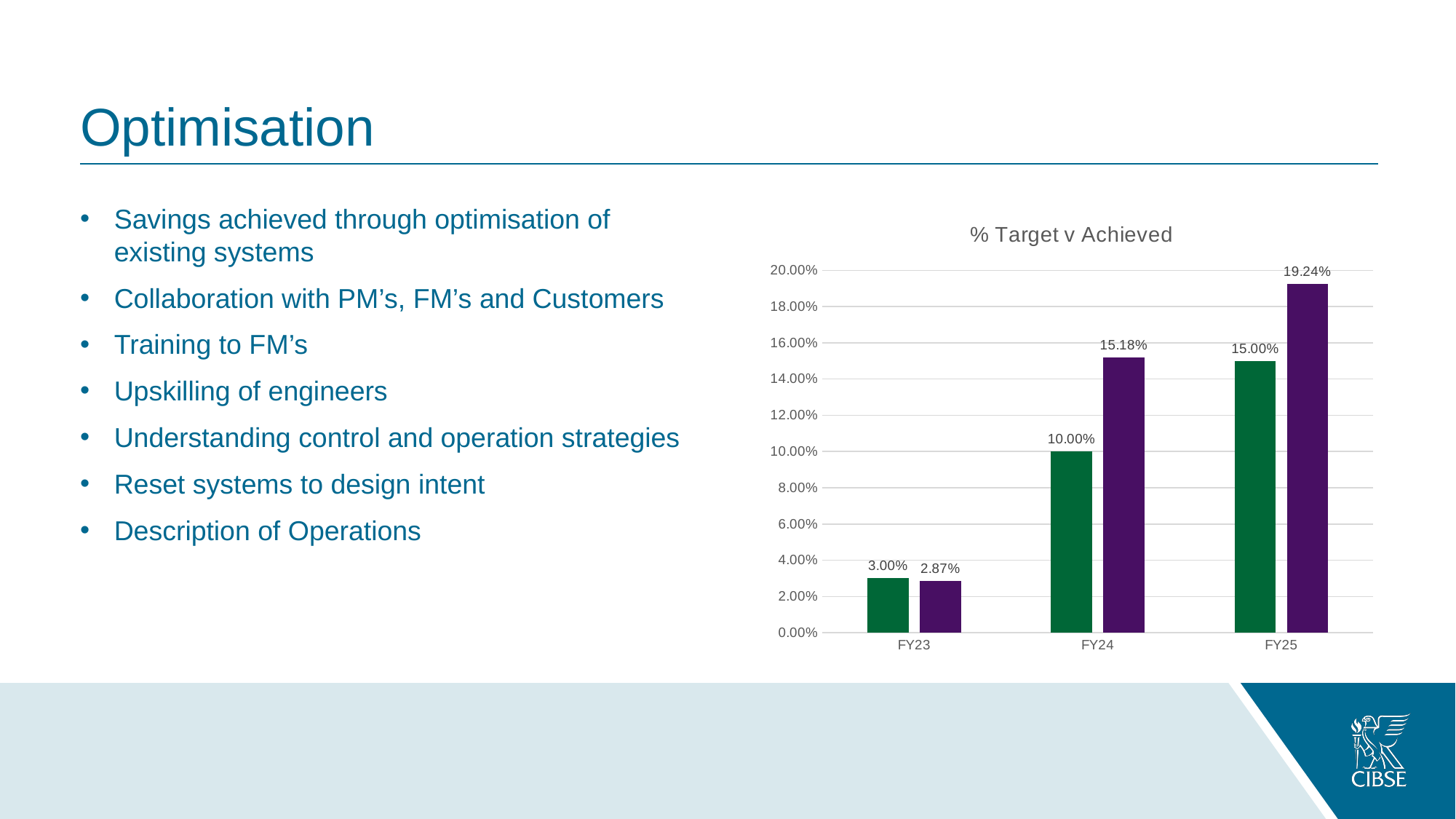
What type of chart is shown on the slide? bar chart What is the title of the chart? % Target v Achieved Do the green bar values rise or fall from FY23 to FY25? rise What is the difference between the purple bar and the green bar for FY24? 5.18% How many categories are shown on the x axis of the chart? 3 Which is larger for FY25, the green bar or the purple bar? the purple bar What is the value of the purple bar for FY23? 2.87% Which category has the highest purple bar? FY25 Which category has the lowest green bar? FY23 What is the value of the green bar for FY25? 15.00% What is the value of the green bar for FY24? 10.00% What is the value of the purple bar for FY25? 19.24%